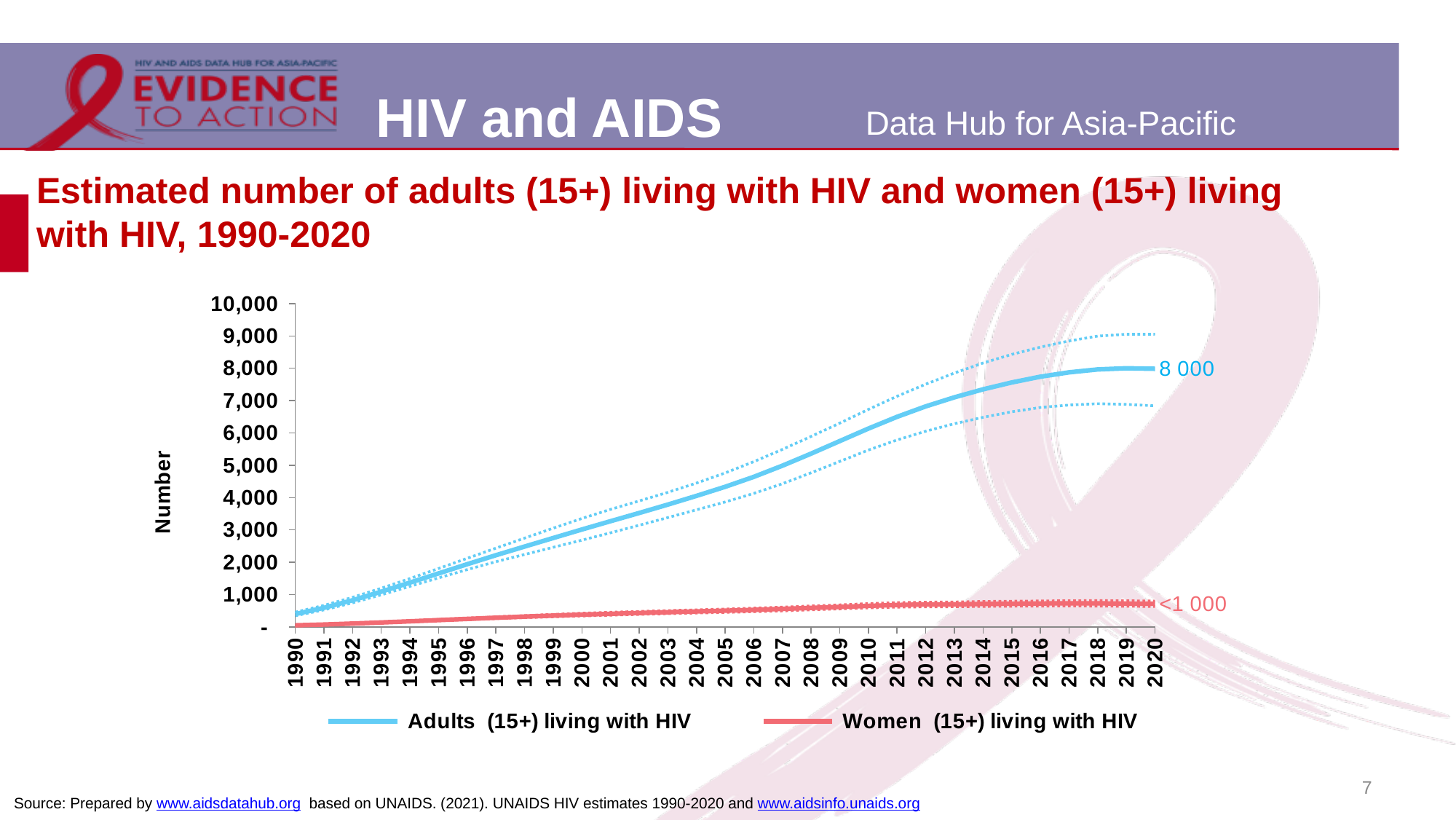
Is the value for Women (15+) living with HIV in 2010 greater or less than 1,000? less Which colour is used for the Women (15+) living with HIV line? Red What kind of chart is shown on the slide? Line chart How many series does the legend list? 2 Is the value for Adults (15+) living with HIV in 2010 greater or less than 5,000? greater In 2020, which series has the larger value, Adults (15+) living with HIV or Women (15+) living with HIV? Adults (15+) living with HIV What is the labelled value for Adults (15+) living with HIV in 2020? 8 000 How many years are shown on the x axis? 31 What is the labelled value for Women (15+) living with HIV in 2020? <1 000 Does the number of Adults (15+) living with HIV rise or fall from 1990 to 2020? Rise What is the title of the y axis? Number Is the value for Adults (15+) living with HIV in 2005 greater or less than 5,000? less